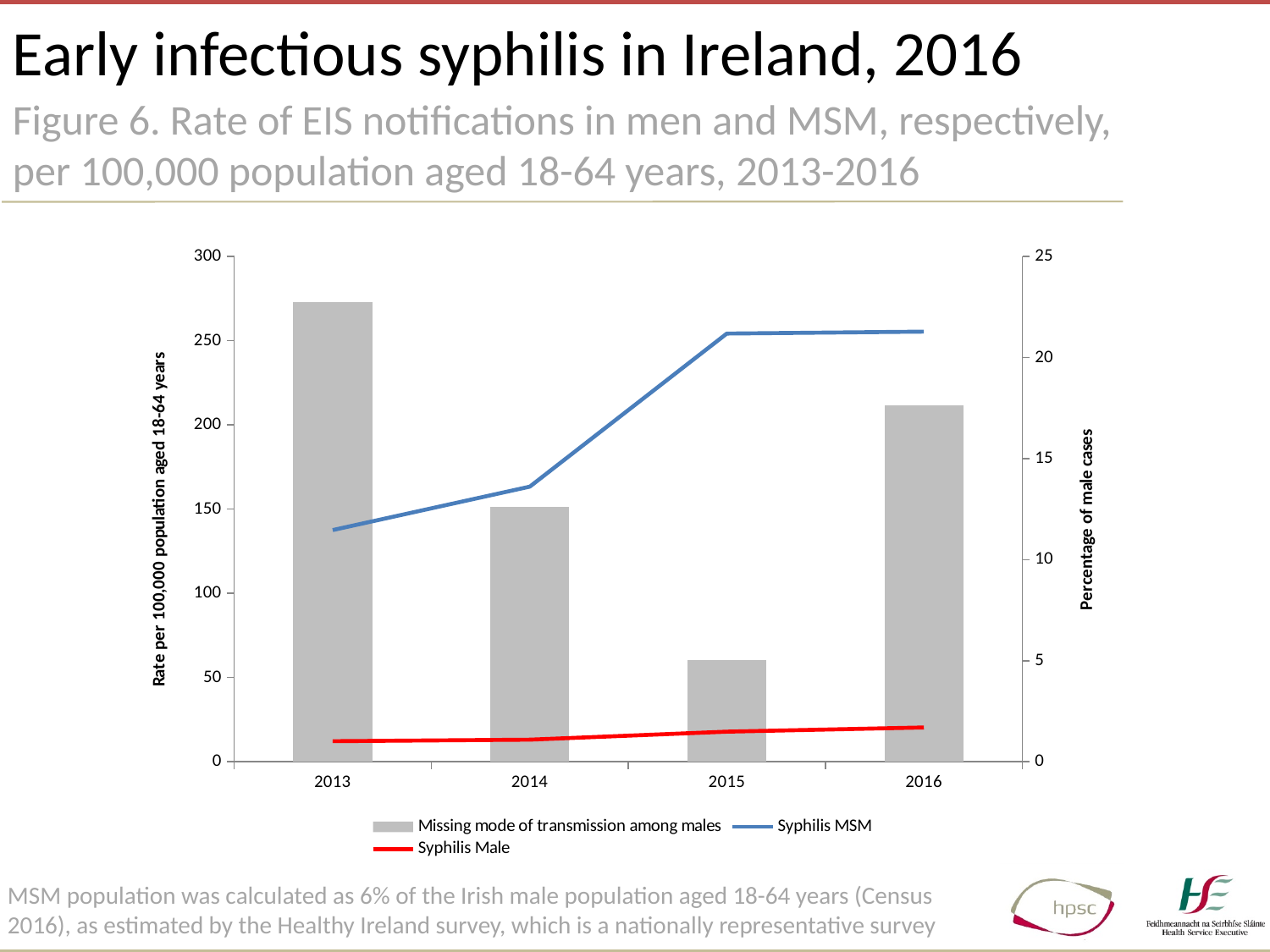
What kind of chart is shown on the slide? A combination bar and line chart In 2016, which line is higher, Syphilis MSM or Syphilis Male? Syphilis MSM On the left-hand axis, is the Syphilis MSM value for 2015 greater or less than 200? greater How many series does the legend list? 3 On the right-hand axis, is the 'Missing mode of transmission among males' bar for 2015 greater or less than 10? less Does the Syphilis MSM line rise or fall from 2013 to 2016? Rises How many years are shown along the x axis? 4 In which year is the bar for 'Missing mode of transmission among males' the tallest? 2013 On the left-hand axis, is the Syphilis MSM value for 2013 greater or less than 150? less In which year is the bar for 'Missing mode of transmission among males' the shortest? 2015 What is the title of the right-hand vertical axis? Percentage of male cases Which year has the taller 'Missing mode of transmission among males' bar, 2014 or 2016? 2016